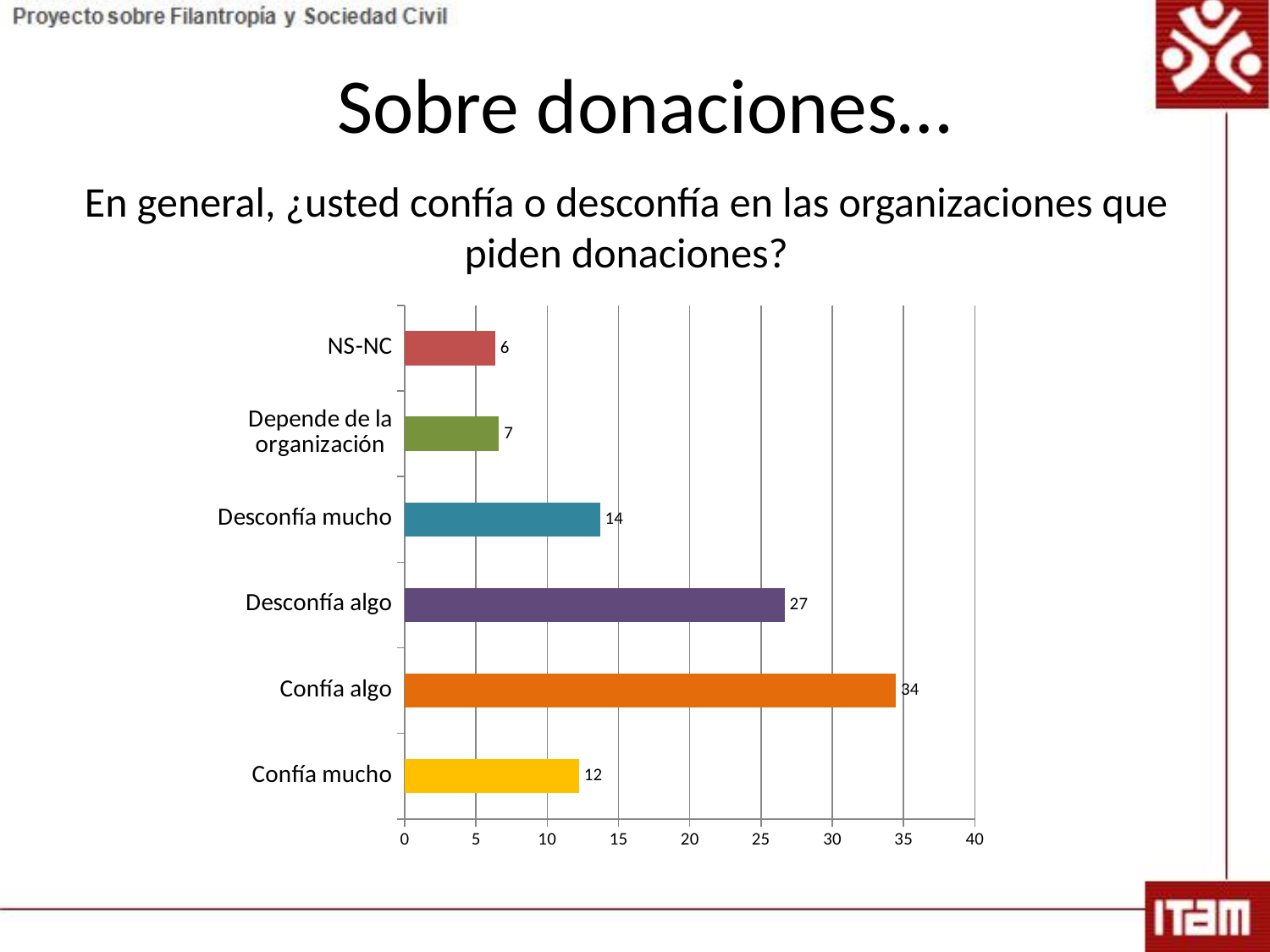
What is the maximum value shown on the horizontal axis? 40 What is the difference between "Depende de la organización" and "NS-NC"? 1 What is the value for "Confía algo"? 34 Which category has the lowest value? NS-NC What is the value for "Desconfía mucho"? 14 Is the value for "Desconfía algo" greater or less than 25? greater Which is larger, "Confía mucho" or "Desconfía mucho"? Desconfía mucho Which category has the highest value? Confía algo What kind of chart is shown on the slide? bar chart What is the value for "NS-NC"? 6 What is the difference between "Confía algo" and "Desconfía algo"? 7 How many categories are shown in the chart? 6